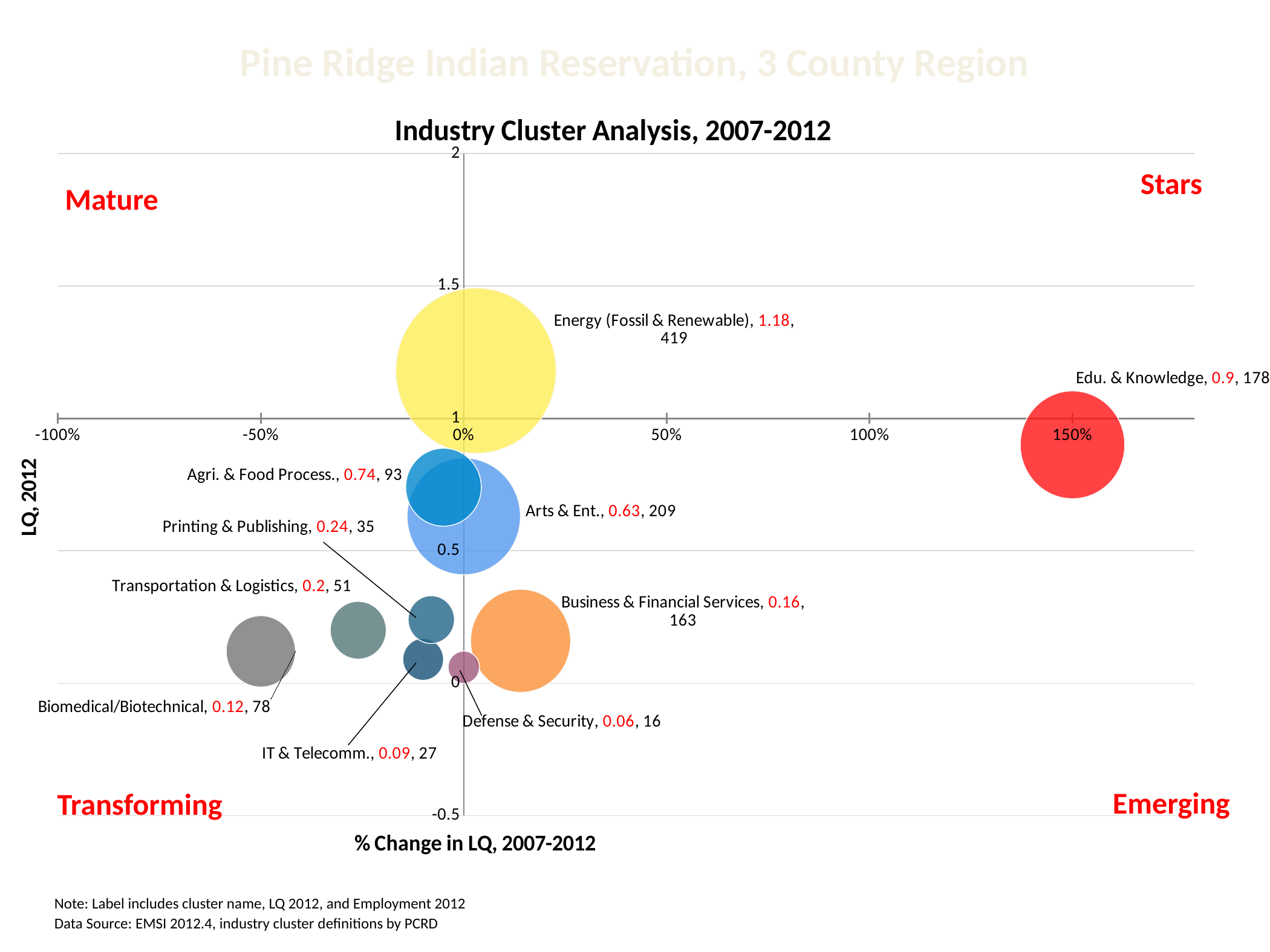
What is the difference in 2012 employment between Energy (Fossil & Renewable) and Edu. & Knowledge? 241 Is the % change in LQ for Edu. & Knowledge greater or less than 100%? greater What is the title of the chart? Industry Cluster Analysis, 2007-2012 What is the LQ 2012 value for Business & Financial Services? 0.16 What is the 2012 employment shown for Arts & Ent.? 209 Which industry cluster has the highest LQ 2012 value? Energy (Fossil & Renewable) How many industry clusters are plotted on the chart? 10 What kind of chart is shown on the slide? Bubble chart What is the LQ 2012 value for Energy (Fossil & Renewable)? 1.18 Is the % change in LQ for Biomedical/Biotechnical greater or less than 0%? less Which industry cluster has the lowest 2012 employment? Defense & Security Which has a higher LQ 2012 value, Agri. & Food Process. or Arts & Ent.? Agri. & Food Process.